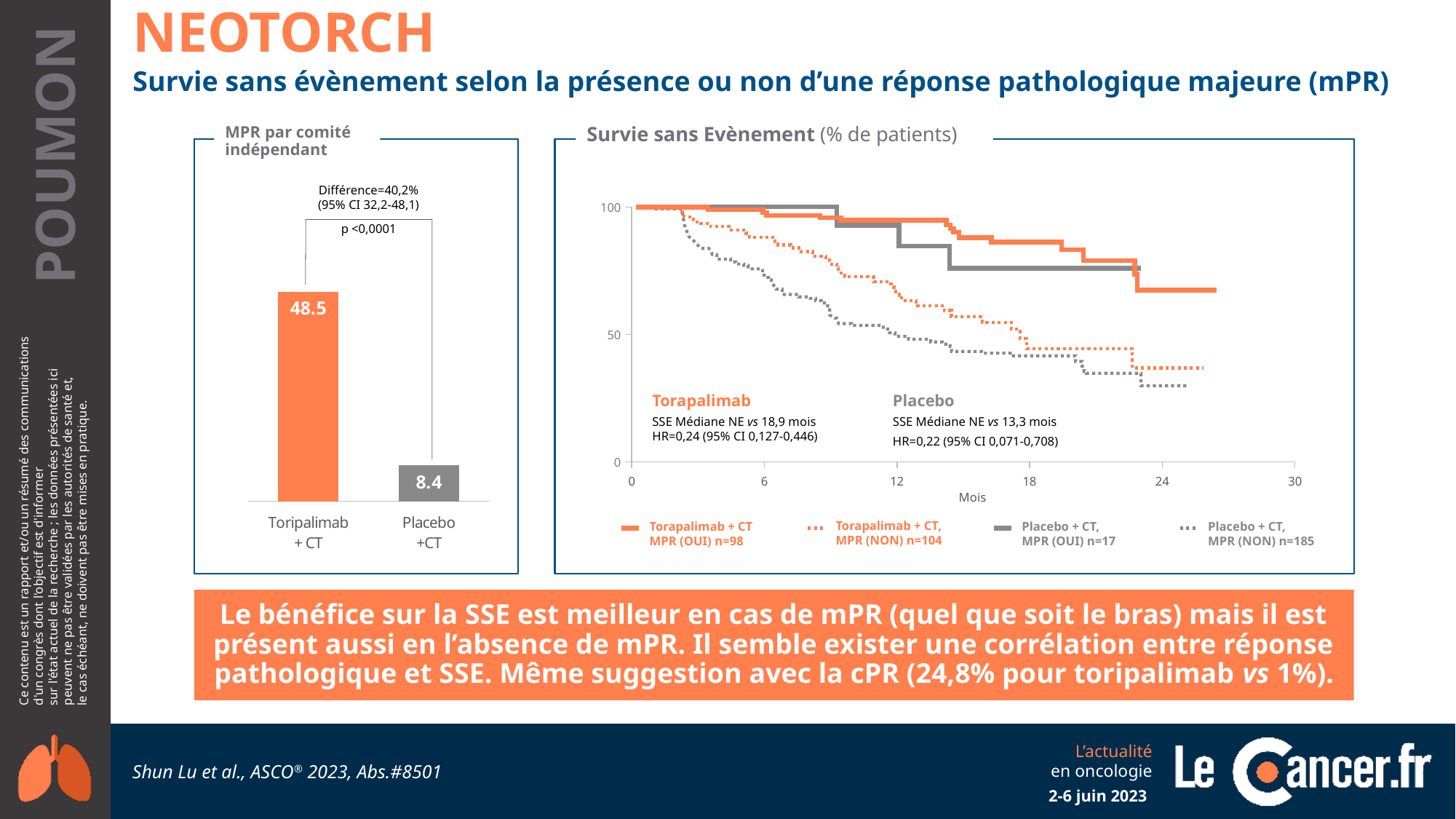
In the 'Survie sans Evènement' chart, do the curves rise or fall as months increase along the x axis? fall In the bar chart 'MPR par comité indépendant', which category has the lowest value? Placebo + CT In the bar chart 'MPR par comité indépendant', what is the value for Toripalimab + CT? 48.5 What kind of chart is the 'Survie sans Evènement' chart on the right? line chart In the bar chart 'MPR par comité indépendant', what p-value is annotated between the two bars? p <0,0001 In the bar chart 'MPR par comité indépendant', how many categories are shown? 2 In the bar chart 'MPR par comité indépendant', which category has the highest value? Toripalimab + CT In the 'Survie sans Evènement' chart, how many series does the legend list? 4 In the bar chart 'MPR par comité indépendant', what is the value for Placebo + CT? 8.4 In the 'Survie sans Evènement' chart, is the value for Placebo + CT, MPR (NON) at 18 months greater or less than 50? less In the 'Survie sans Evènement' chart, is the value for Torapalimab + CT, MPR (OUI) at 24 months greater or less than 50? greater What kind of chart is the 'MPR par comité indépendant' chart on the left? bar chart